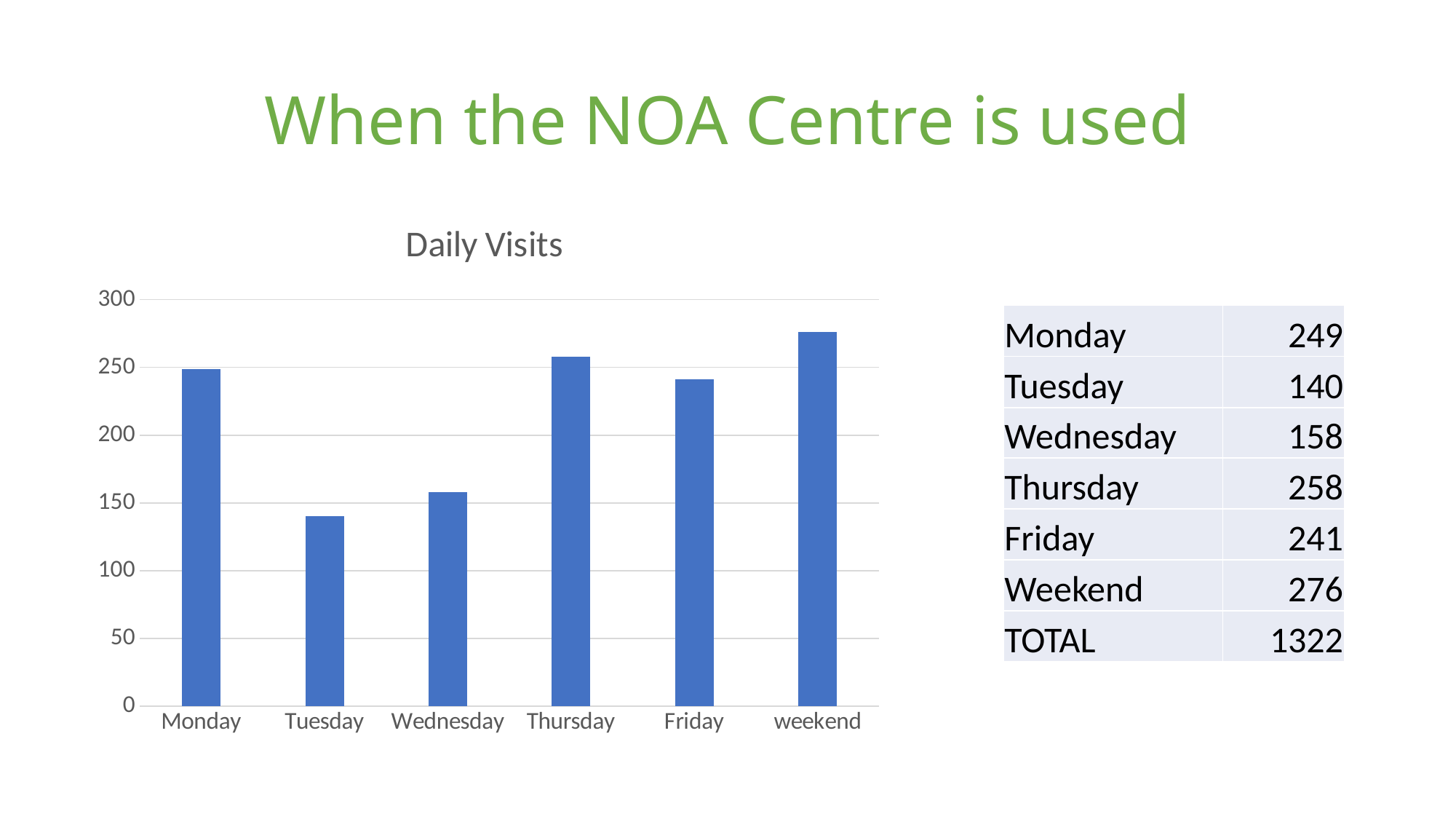
According to the slide, what is the number of daily visits on Thursday? 258 Is the value for Wednesday greater or less than 200? less According to the slide, what is the number of daily visits on Monday? 249 How many categories are shown on the x axis of the chart? 6 Do the values rise or fall from Tuesday to Thursday? rise Which category has the highest value in the chart? weekend Is the value for Friday greater or less than 200? greater What is the title of the chart? Daily Visits Which is larger, the value for Monday or the value for Wednesday? Monday What type of chart is shown on the slide? bar chart Which category has the lowest value in the chart? Tuesday What is the difference between the Weekend value and the Tuesday value, using the figures on the slide? 136